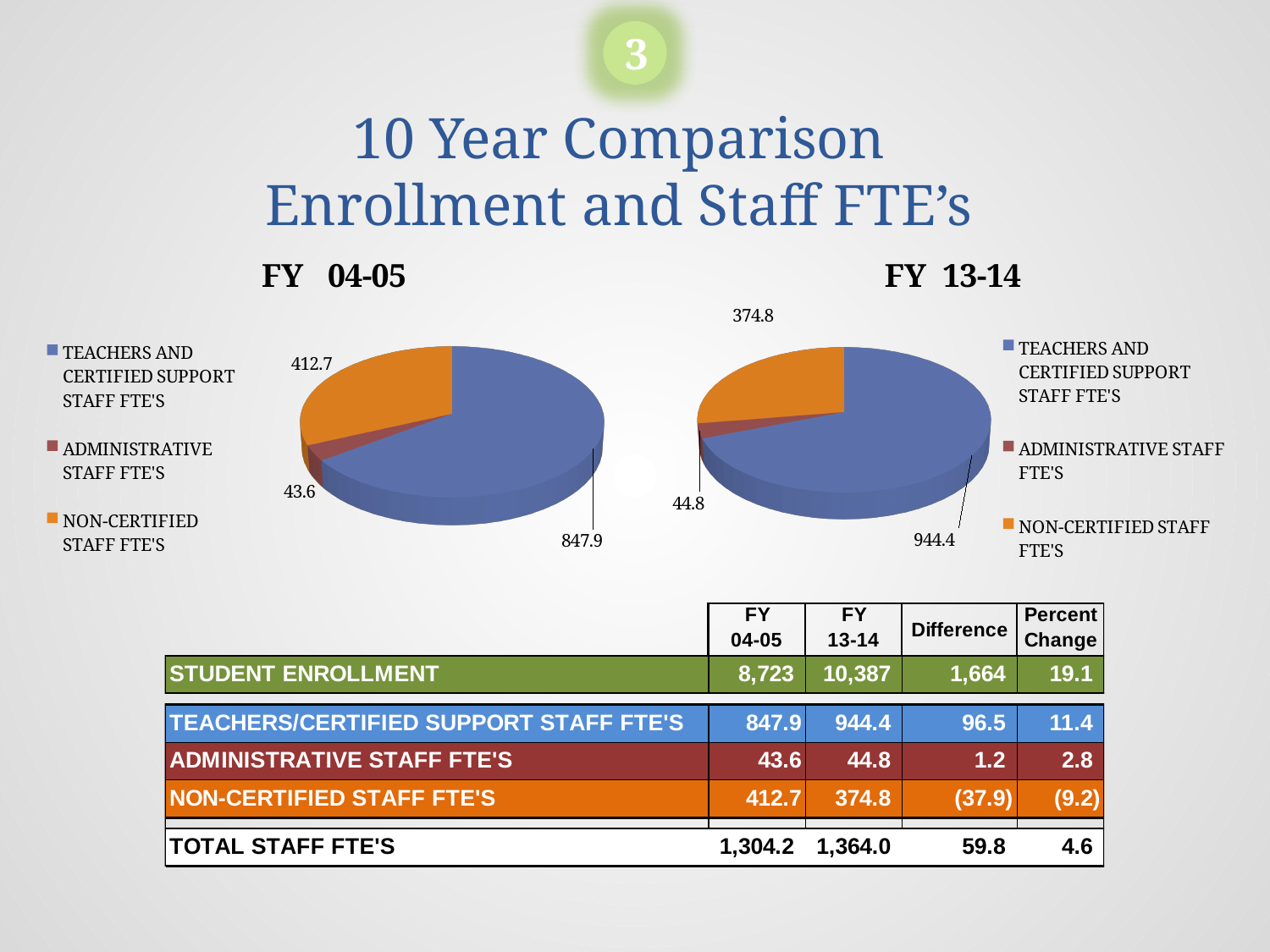
In the FY 04-05 pie chart, what is the value for Administrative Staff FTE's? 43.6 In the FY 04-05 pie chart, what is the value for Teachers and Certified Support Staff FTE's? 847.9 How many entries does the legend of the FY 04-05 pie chart list? 3 In the FY 13-14 pie chart, what is the value for Non-Certified Staff FTE's? 374.8 What type of chart is used for FY 04-05? Pie chart In the FY 13-14 pie chart, what colour is the Administrative Staff FTE's slice? Red In the FY 13-14 pie chart, what is the difference between the Teachers and Certified Support Staff FTE's value and the Non-Certified Staff FTE's value? 569.6 In the FY 13-14 pie chart, which category has the largest slice? Teachers and Certified Support Staff FTE's In the FY 04-05 pie chart, what is the total of the three slice values? 1,304.2 In the FY 04-05 pie chart, which is larger: Non-Certified Staff FTE's or Administrative Staff FTE's? Non-Certified Staff FTE's How many slices does the FY 13-14 pie chart have? 3 In the FY 04-05 pie chart, which category has the smallest slice? Administrative Staff FTE's